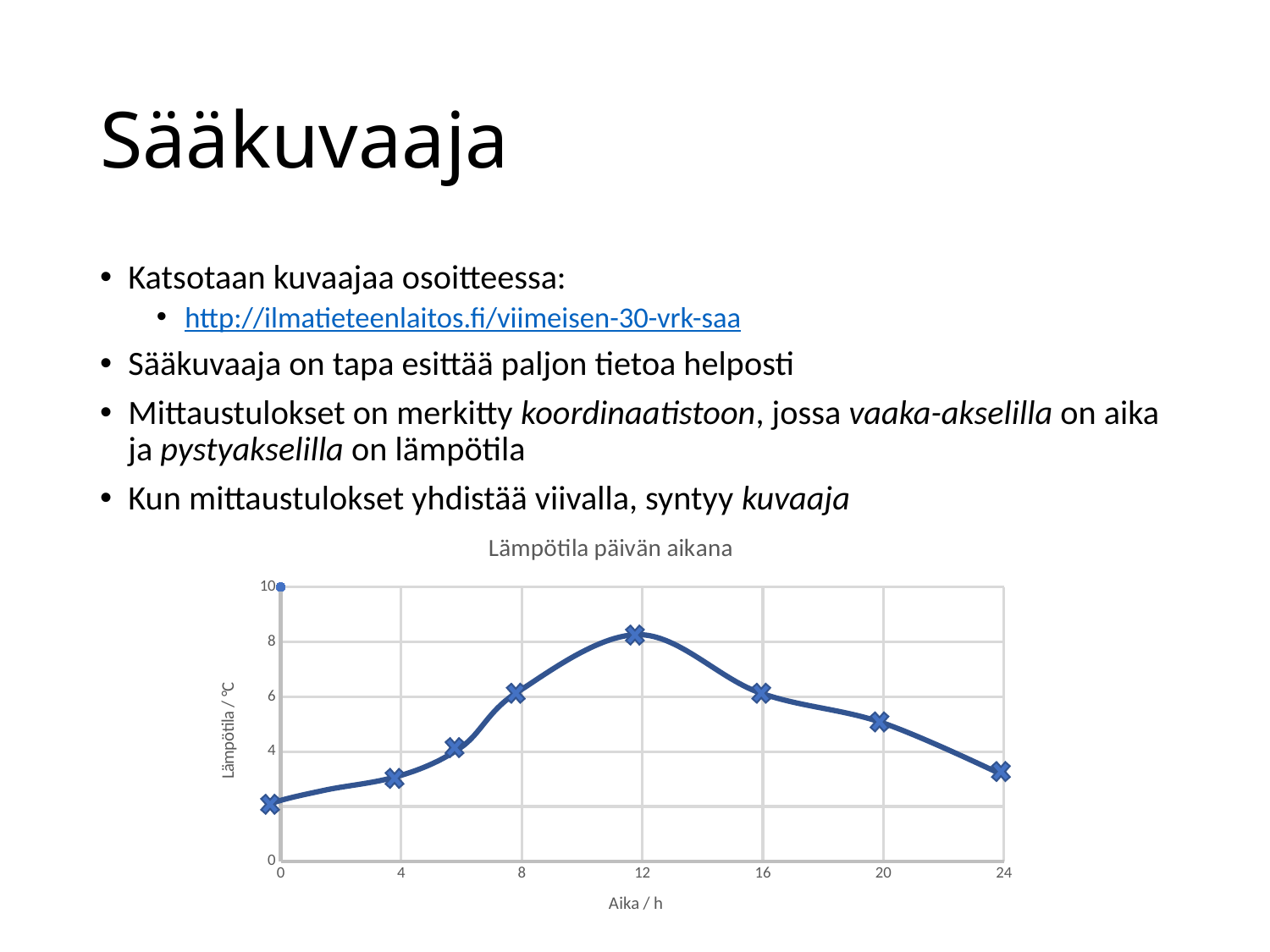
Between 0 h and 12 h, does the temperature rise or fall? rise Is the temperature at around 20 h greater or less than 4 °C? greater What kind of chart is shown on the slide? line chart Is the temperature at around 12 h greater or less than 6 °C? greater Which is higher: the temperature at around 4 h or at around 20 h? around 20 h Is the temperature at 0 h greater or less than 4 °C? less Between 12 h and 24 h, does the temperature rise or fall? fall What is the title of the chart? Lämpötila päivän aikana What is the label of the horizontal axis of the chart? Aika / h